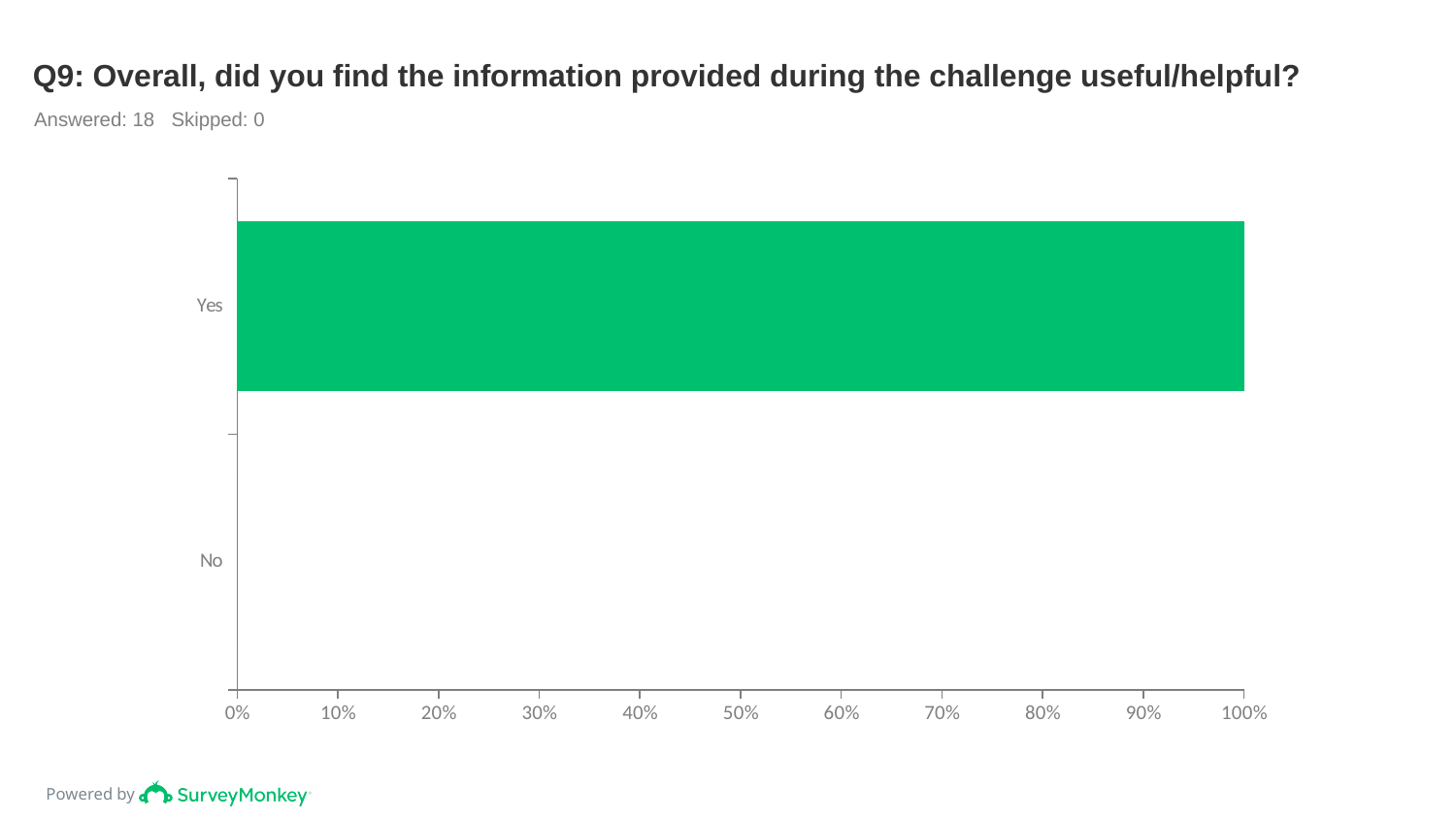
Is the value for Yes greater or less than 50%? greater What colour is the bar for Yes? green What is the value for Yes? 100% What is the value for No? 0% What is the difference between the values for Yes and No? 100% What kind of chart is shown on the slide? bar chart Which category has the highest value? Yes How many respondents answered this question according to the slide? 18 How many categories are shown on the chart? 2 Is the value for No greater or less than 10%? less Which category has the lowest value? No Which is larger, the value for Yes or the value for No? Yes